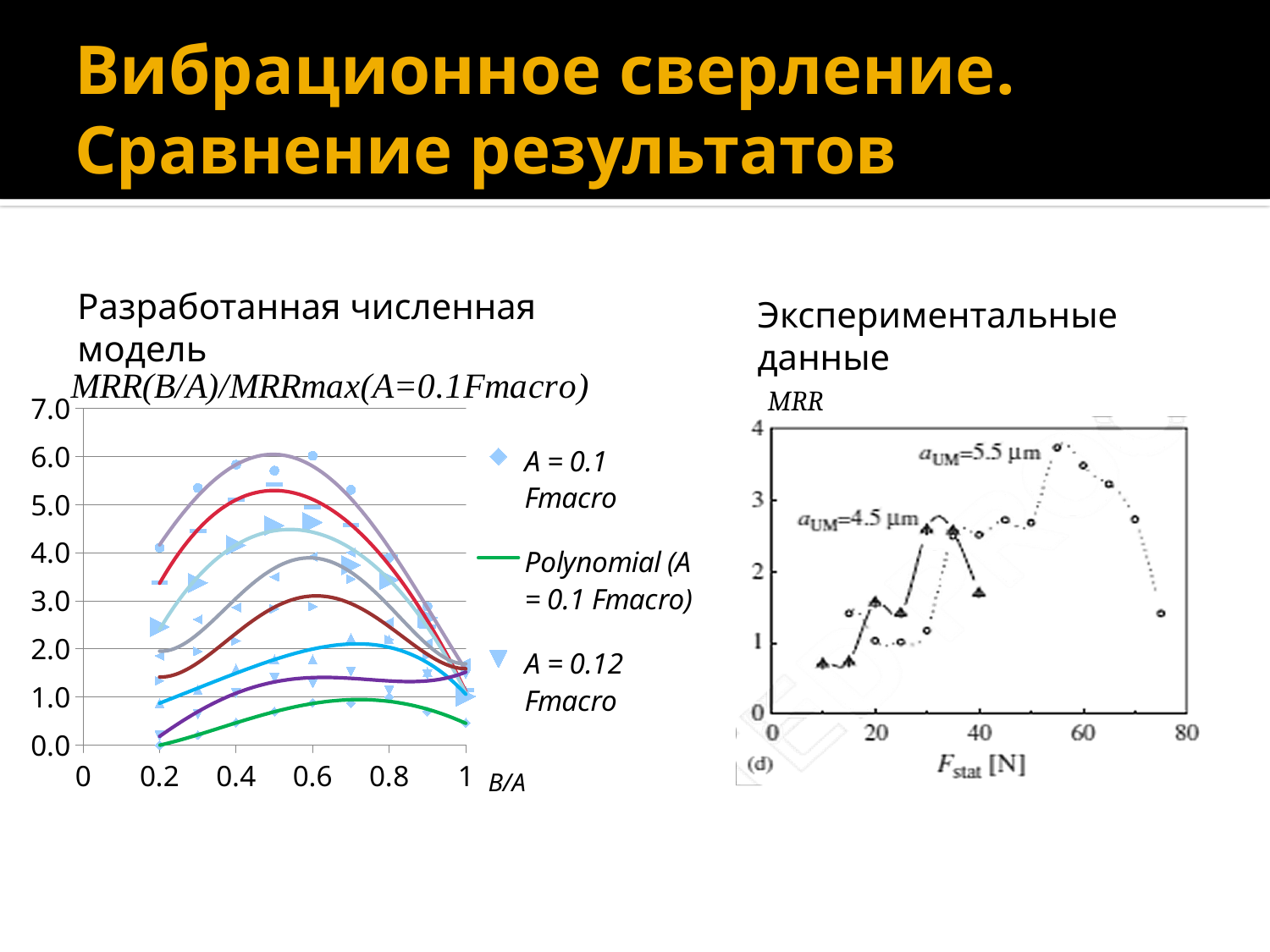
On the left chart, what is the label of the x axis? B/A On the left chart, is the value of the topmost curve at B/A = 1 greater or less than 3.0? less On the right chart (experimental data), is the maximum value of the a_UM=5.5 µm series greater or less than 3? greater On the left chart, is the highest point plotted on the chart greater or less than 5.0? greater On the left chart, what is the highest value shown on the y axis? 7.0 On the left chart, does the Polynomial (A = 0.1 Fmacro) curve rise or fall between B/A = 0.2 and B/A = 0.6? rises On the right chart (experimental data), which series reaches the higher MRR value, a_UM=4.5 µm or a_UM=5.5 µm? a_UM=5.5 µm On the right chart (experimental data), how many series are plotted? 2 On the right chart (experimental data), what is the label of the x axis? F_stat [N] What kind of chart is the left chart titled MRR(B/A)/MRRmax(A=0.1Fmacro)? scatter chart with smoothed trend lines